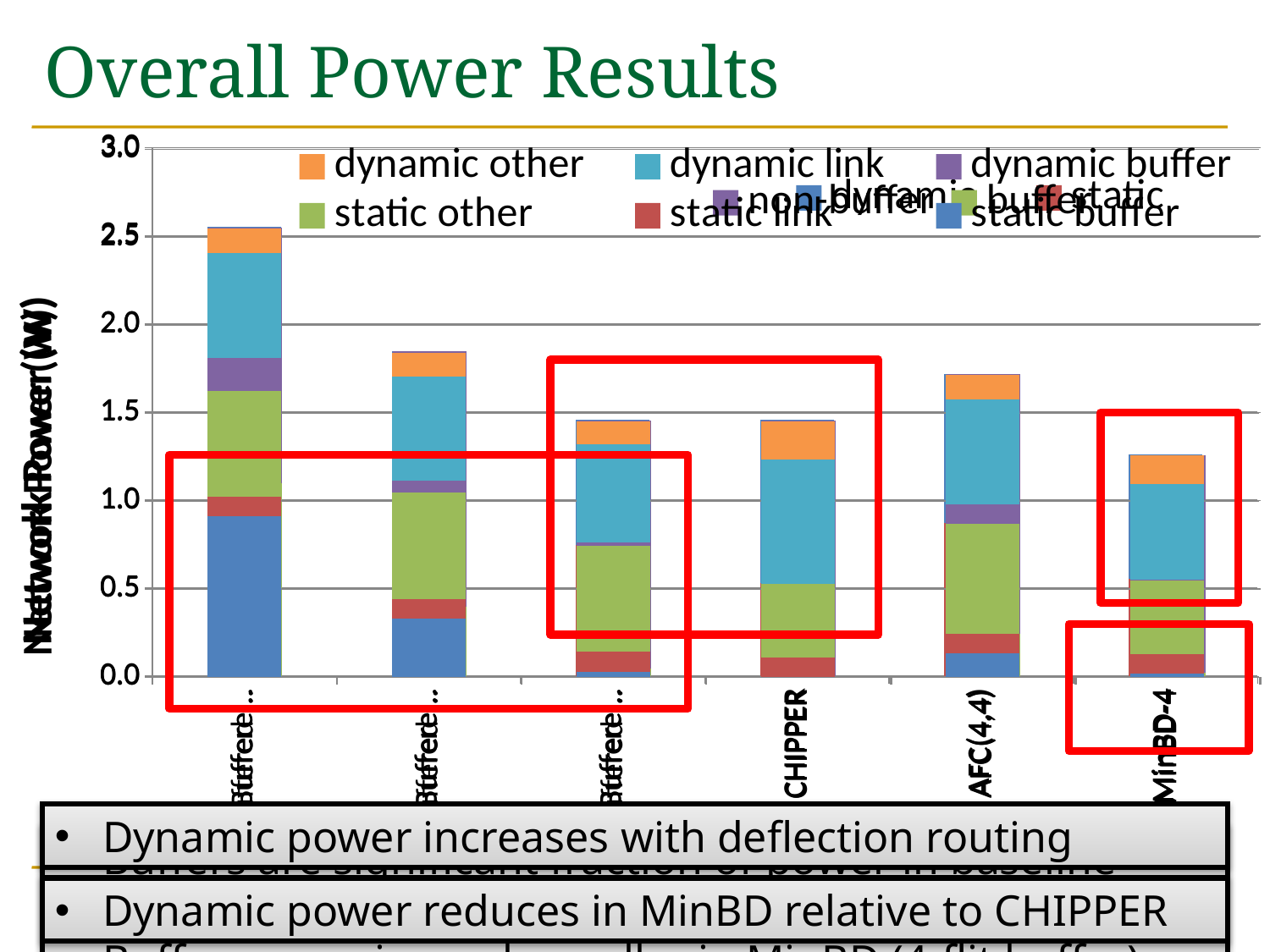
Which has the larger total network power, AFC(4,4) or CHIPPER? AFC(4,4) Among CHIPPER, AFC(4,4) and MinBD-4, which has the lowest total network power? MinBD-4 Is the total network power of the leftmost bar greater or less than 2.0? greater What colour represents the 'dynamic link' series in the legend? light blue Is the total network power for AFC(4,4) greater or less than 1.5? greater How many bars (categories) are plotted in the chart? 6 What is the label on the vertical axis of the chart? Network Power (W) Among CHIPPER, AFC(4,4) and MinBD-4, which has the highest total network power? AFC(4,4) Is the total network power for MinBD-4 greater or less than 1.5? less Which has the larger total network power, CHIPPER or MinBD-4? CHIPPER What kind of chart is shown on the slide? stacked bar chart